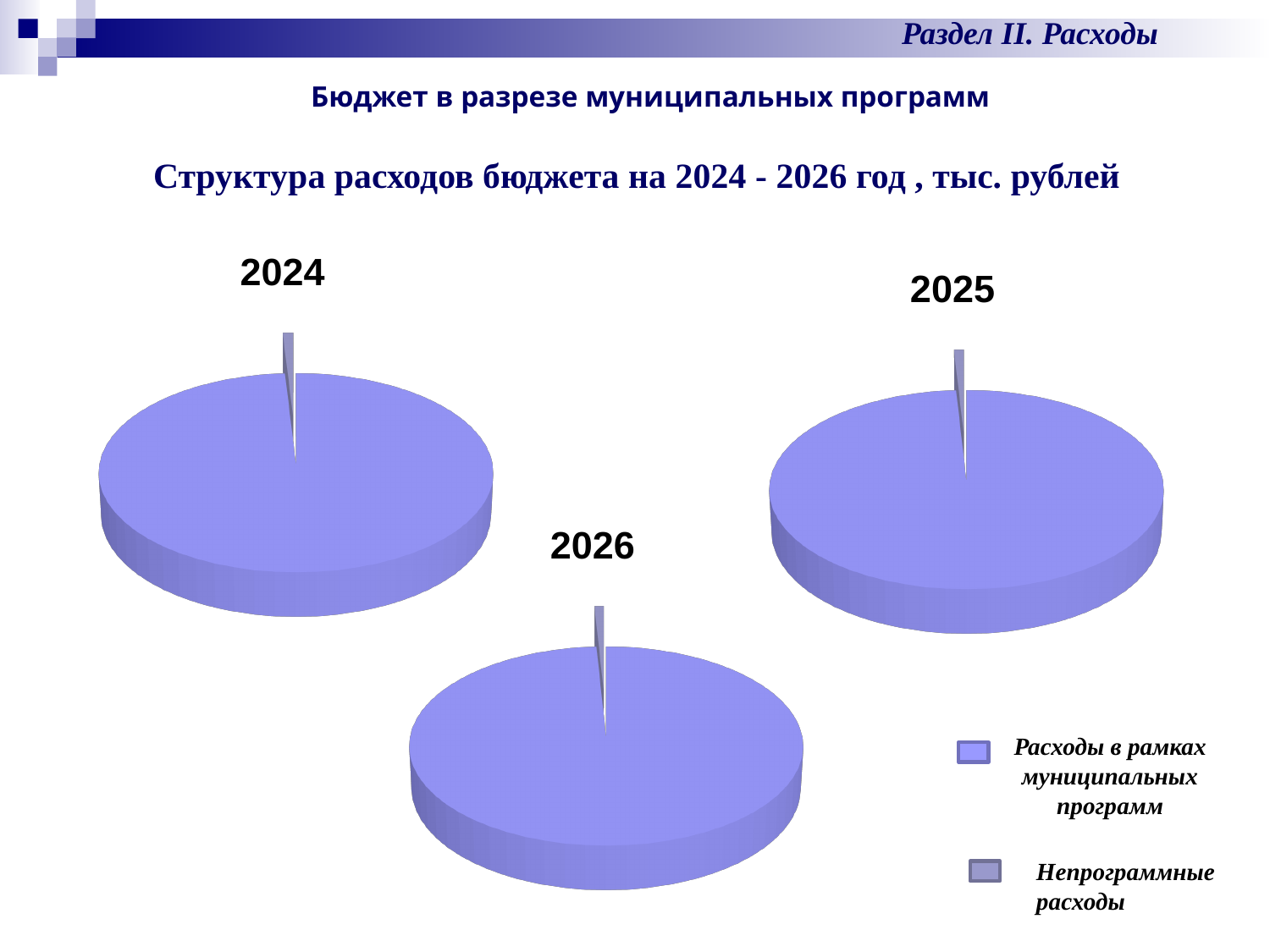
In the 2024 pie chart, which category has the largest slice? Расходы в рамках муниципальных программ What kind of chart is used for the 2024 chart? pie chart In the 2025 pie chart, which category has the smallest slice? Непрограммные расходы In the 2026 pie chart, which category has the largest slice? Расходы в рамках муниципальных программ How many slices does the 2025 pie chart have? 2 What is the unit of measurement stated in the main title above the charts? тыс. рублей In the 2026 pie chart, which is larger: Расходы в рамках муниципальных программ or Непрограммные расходы? Расходы в рамках муниципальных программ How many entries does the legend list? 2 Which years are shown as titles of the three pie charts? 2024, 2025, 2026 In the 2024 pie chart, which category has the smallest slice? Непрограммные расходы How many pie charts are shown on the slide? 3